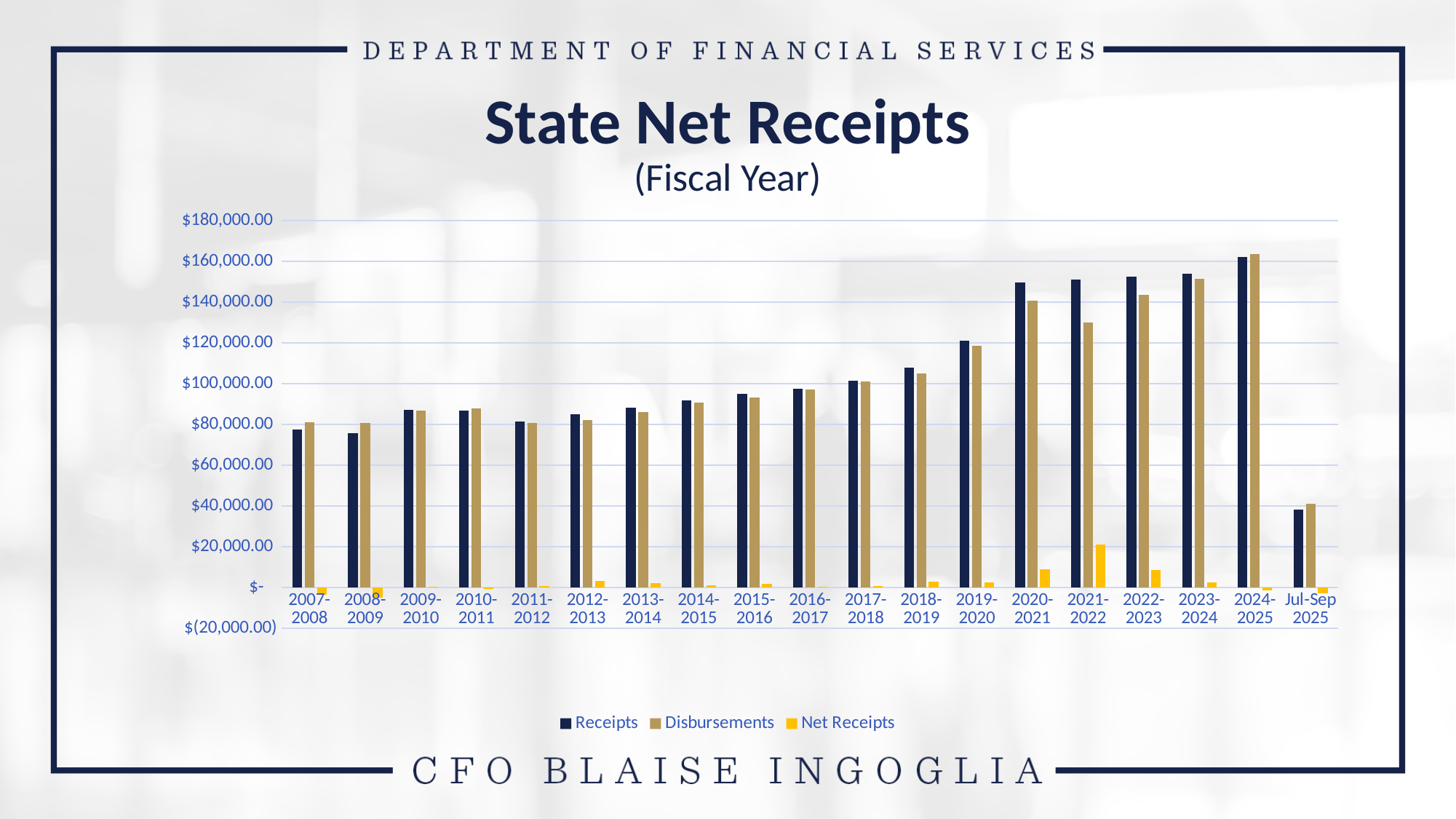
How many fiscal-year categories are shown on the x axis? 19 Which fiscal year has the highest Net Receipts value? 2021-2022 In 2008-2009, which is larger: Receipts or Disbursements? Disbursements Which category has the lowest Receipts value? Jul-Sep 2025 In 2021-2022, which is larger: Receipts or Disbursements? Receipts Which fiscal year has the highest Receipts value? 2024-2025 Is the Disbursements value for 2024-2025 greater or less than $160,000.00? greater Is the Receipts value for 2007-2008 greater or less than $80,000.00? less Is the Receipts value for 2020-2021 greater or less than $140,000.00? greater Do Receipts generally rise or fall from 2007-2008 to 2024-2025? Rise How many series does the legend list? 3 What type of chart is shown on the slide? Bar chart